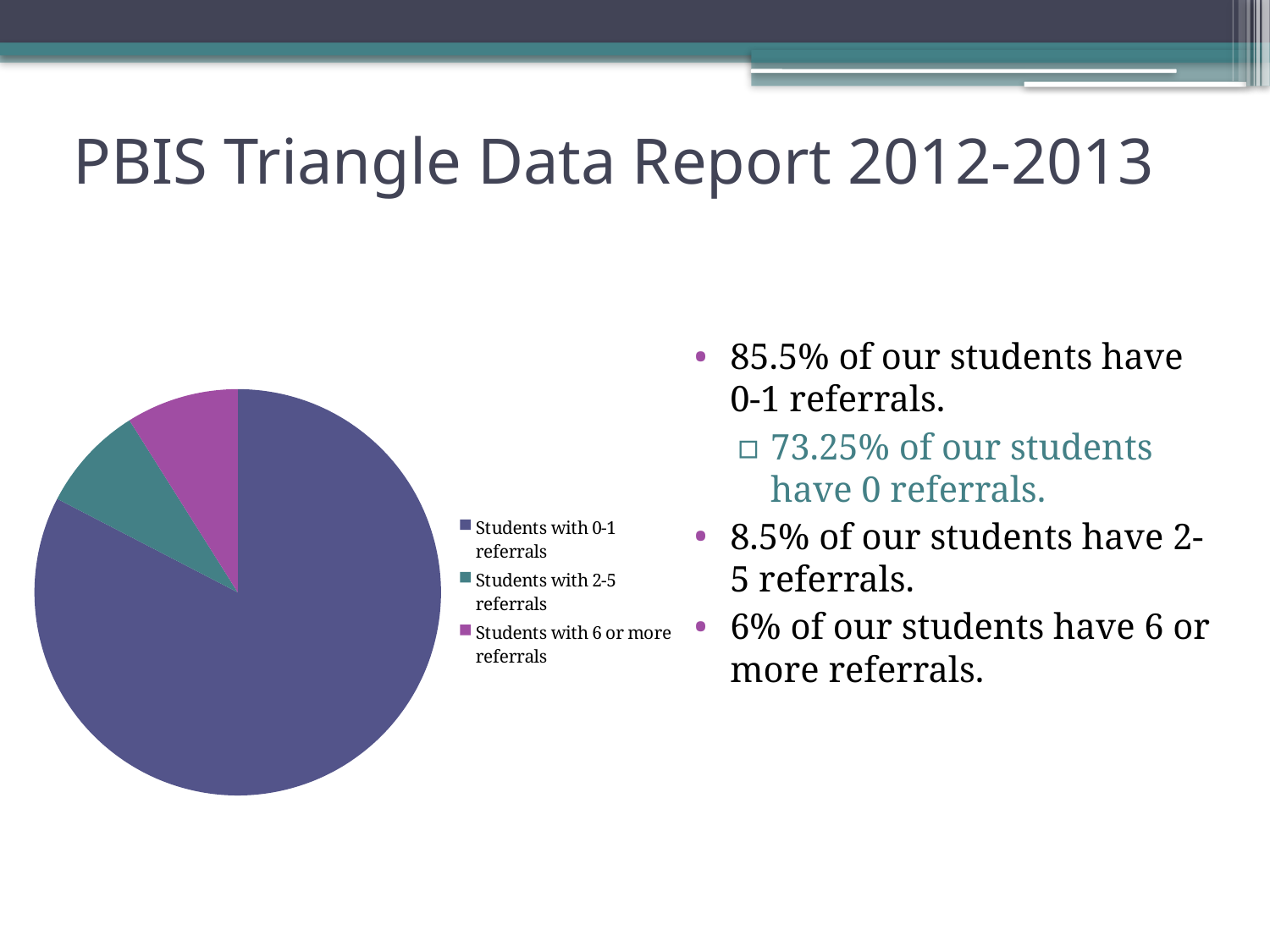
According to the slide, what share of students have 2-5 referrals? 8.5% What kind of chart is shown on the slide? pie chart How many entries does the pie chart's legend list? 3 How many slices does the pie chart have? 3 What is the title of the slide containing the pie chart? PBIS Triangle Data Report 2012-2013 Which category takes up the largest slice of the pie chart? Students with 0-1 referrals According to the slide, what share of students have 0-1 referrals? 85.5% Is the slice for Students with 0-1 referrals greater or less than half of the pie? greater According to the slide, what share of students have 6 or more referrals? 6% By how many percentage points does the share of students with 0-1 referrals exceed the share with 2-5 referrals? 77